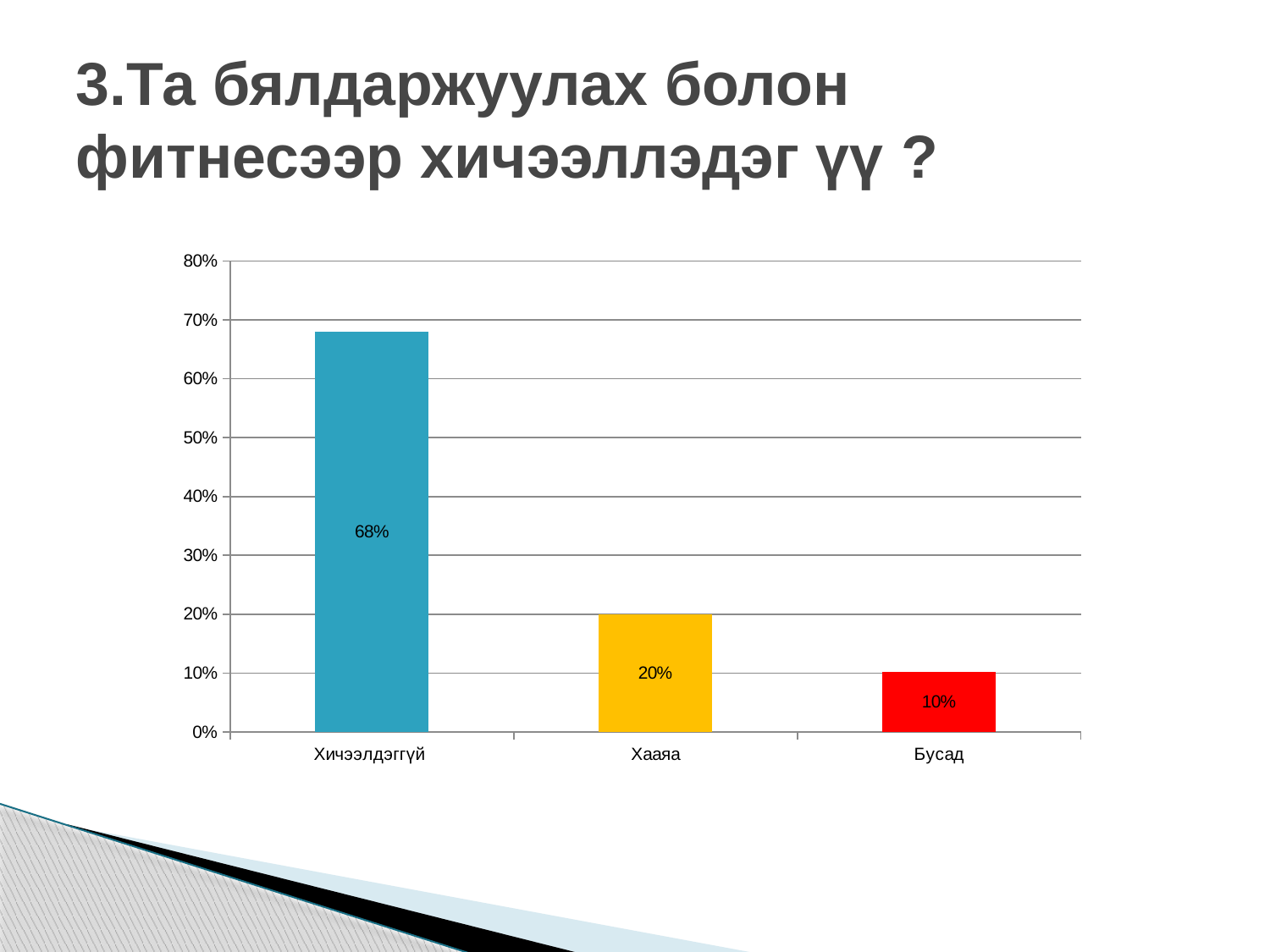
What is the value for Хичээлдэггүй? 68% What is the value for Бусад? 10% Which category has the lowest value? Бусад How many categories are shown on the x axis? 3 Which is larger, the value for Хаяа or the value for Бусад? Хаяа What is the difference between the values for Хичээлдэггүй and Хаяа? 48% What kind of chart is shown on the slide? bar chart Do the values rise or fall from left to right along the x axis? fall What is the difference between the values for Хаяа and Бусад? 10% Is the value for Хичээлдэггүй greater or less than 60%? greater Which category has the highest value? Хичээлдэггүй What is the value for Хаяа? 20%